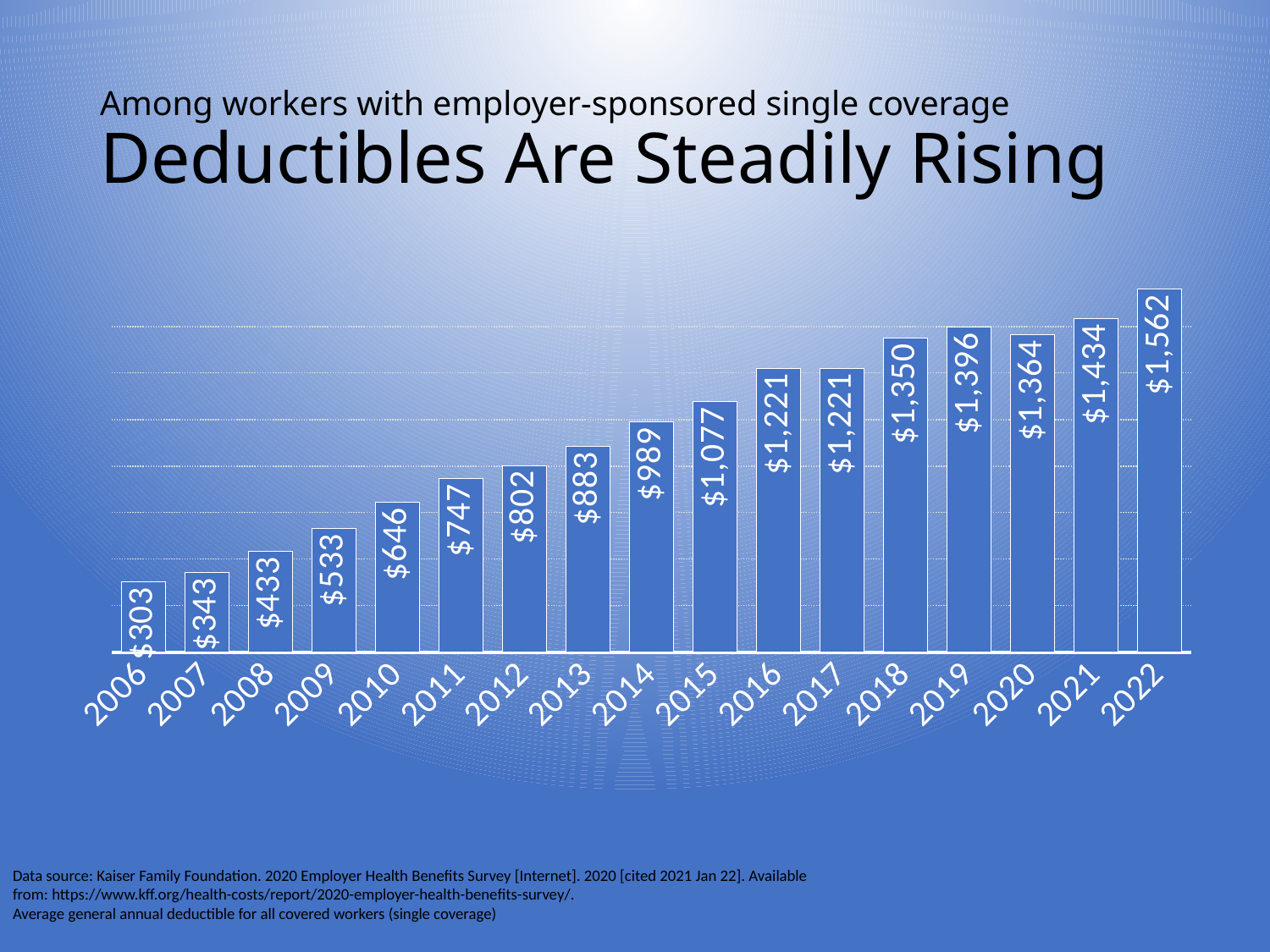
What is the average deductible shown for 2006? $303 Which year has the highest deductible on the chart? 2022 What is the average deductible shown for 2022? $1,562 What is the difference between the deductible in 2020 and the deductible in 2019? $32 What is the main title of the chart on the slide? Deductibles Are Steadily Rising How many years are shown on the chart? 17 Which is larger, the deductible for 2019 or the deductible for 2020? 2019 What is the average deductible shown for 2015? $1,077 Do the deductible values generally rise or fall from 2006 to 2022? Rise What is the difference between the deductible in 2022 and the deductible in 2006? $1,259 Which year has the lowest deductible on the chart? 2006 What kind of chart is shown on the slide? Bar chart